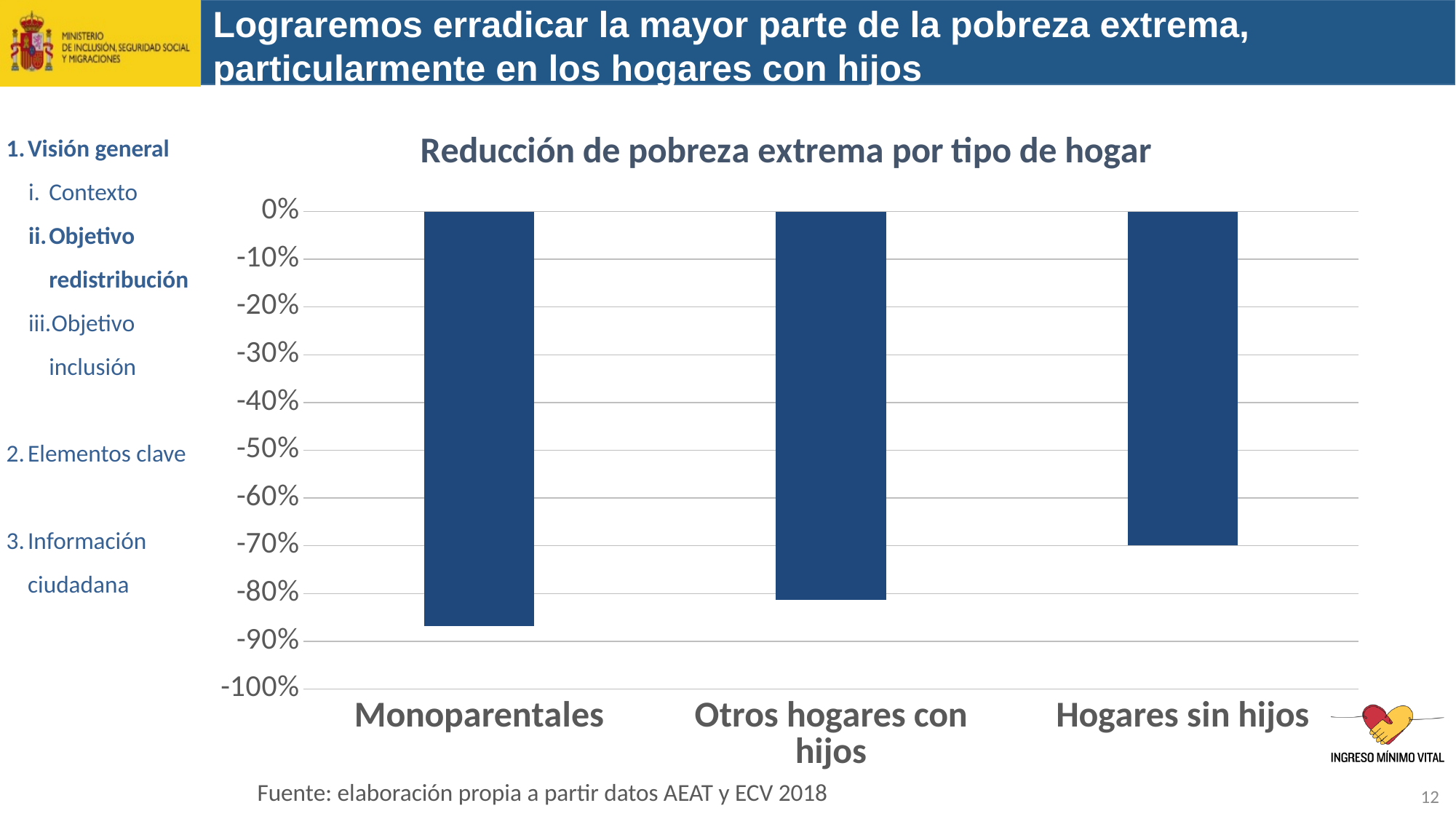
What source is cited below the chart? Fuente: elaboración propia a partir datos AEAT y ECV 2018 Is the value for Otros hogares con hijos greater or less than -90%? greater Do the bar values rise or fall (become less negative or more negative) from left to right along the x axis? rise What kind of chart is shown on the slide? bar chart Which household type shows the largest reduction in extreme poverty (the most negative bar)? Monoparentales What is the title of the chart? Reducción de pobreza extrema por tipo de hogar Which shows a larger reduction in extreme poverty, Monoparentales or Hogares sin hijos? Monoparentales Is the value for Hogares sin hijos greater or less than -60%? less How many household categories are shown on the x axis of the chart? 3 Which household type shows the smallest reduction in extreme poverty (the least negative bar)? Hogares sin hijos Is the value for Monoparentales greater or less than -80%? less